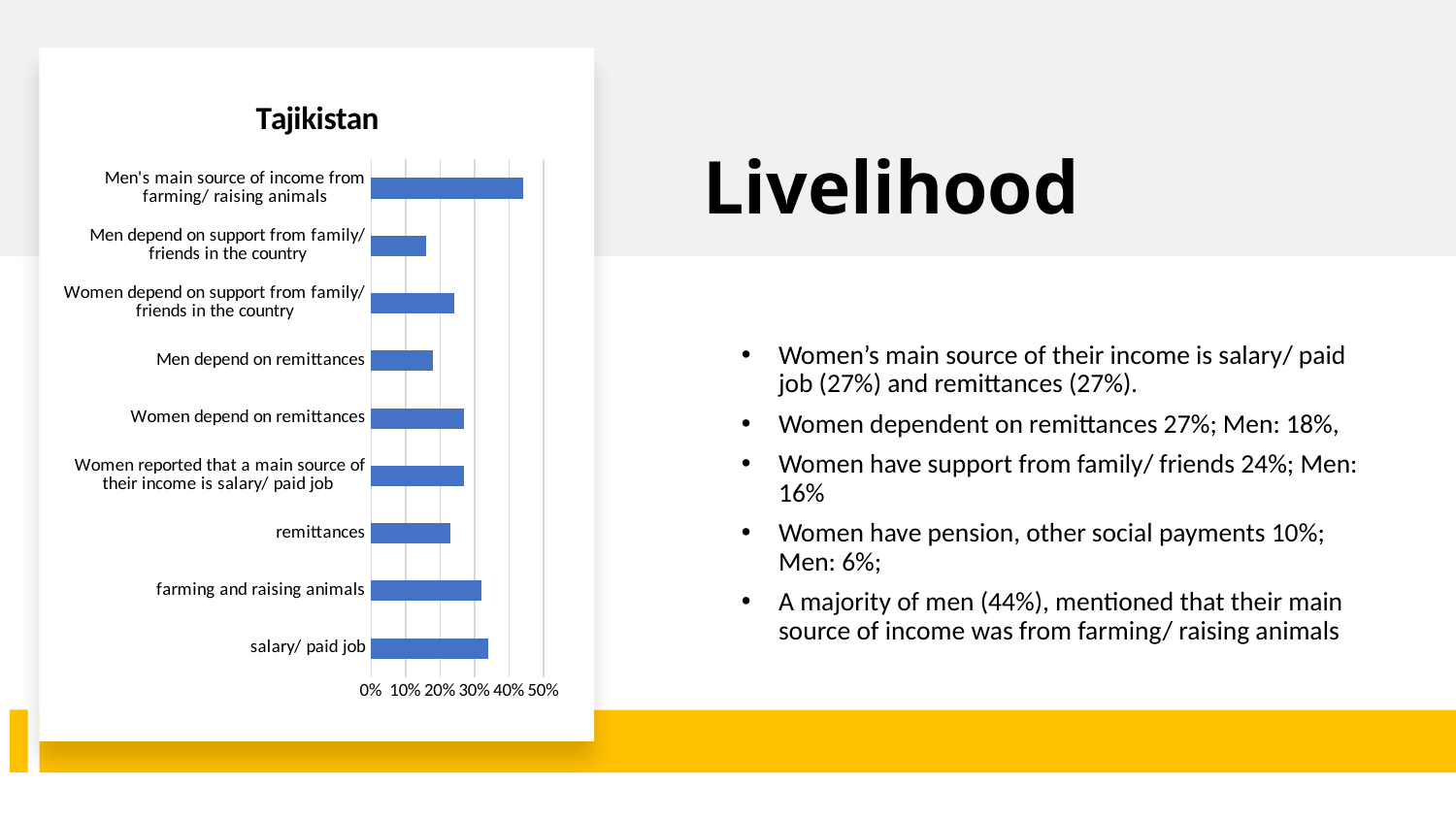
Is the value for "Men's main source of income from farming/ raising animals" greater or less than 40%? greater Is the value for "salary/ paid job" greater or less than 30%? greater What kind of chart is shown on the slide? bar chart Which category has the highest value in the chart? Men's main source of income from farming/ raising animals Is the value for "Women depend on support from family/ friends in the country" greater or less than 20%? greater What colour are the bars in the chart? blue What is the title of the chart? Tajikistan Which is larger: the value for "Men's main source of income from farming/ raising animals" or the value for "salary/ paid job"? Men's main source of income from farming/ raising animals Which is larger: the value for "Women depend on remittances" or the value for "Men depend on remittances"? Women depend on remittances How many categories are plotted in the chart? 9